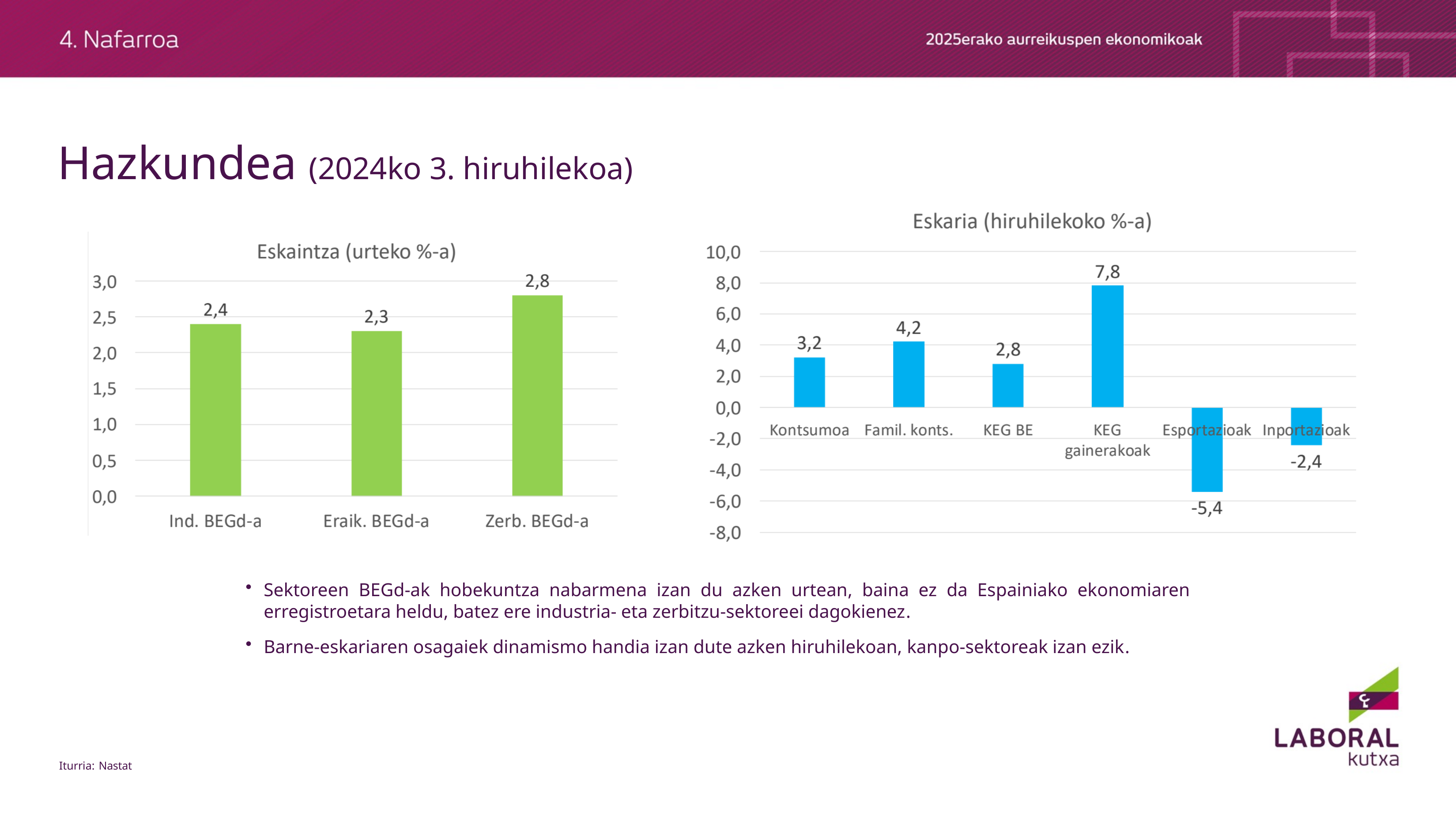
In the 'Eskaintza (urteko %-a)' chart, which category has the highest value? Zerb. BEGd-a In the 'Eskaria (hiruhilekoko %-a)' chart, which is larger, Kontsumoa or Famil. konts.? Famil. konts. In the 'Eskaintza (urteko %-a)' chart, what is the difference between Zerb. BEGd-a and Eraik. BEGd-a? 0,5 In the 'Eskaria (hiruhilekoko %-a)' chart, what is the value for Esportazioak? -5,4 What type of chart is the 'Eskaria (hiruhilekoko %-a)' chart? Bar chart In the 'Eskaria (hiruhilekoko %-a)' chart, what is the difference between Famil. konts. and KEG BE? 1,4 In the 'Eskaria (hiruhilekoko %-a)' chart, how many categories are shown? 6 In the 'Eskaria (hiruhilekoko %-a)' chart, what is the value for KEG gainerakoak? 7,8 In the 'Eskaintza (urteko %-a)' chart, what is the value for Ind. BEGd-a? 2,4 In the 'Eskaintza (urteko %-a)' chart, how many categories are shown? 3 In the 'Eskaria (hiruhilekoko %-a)' chart, which category has the lowest value? Esportazioak In the 'Eskaintza (urteko %-a)' chart, which category has the lowest value? Eraik. BEGd-a